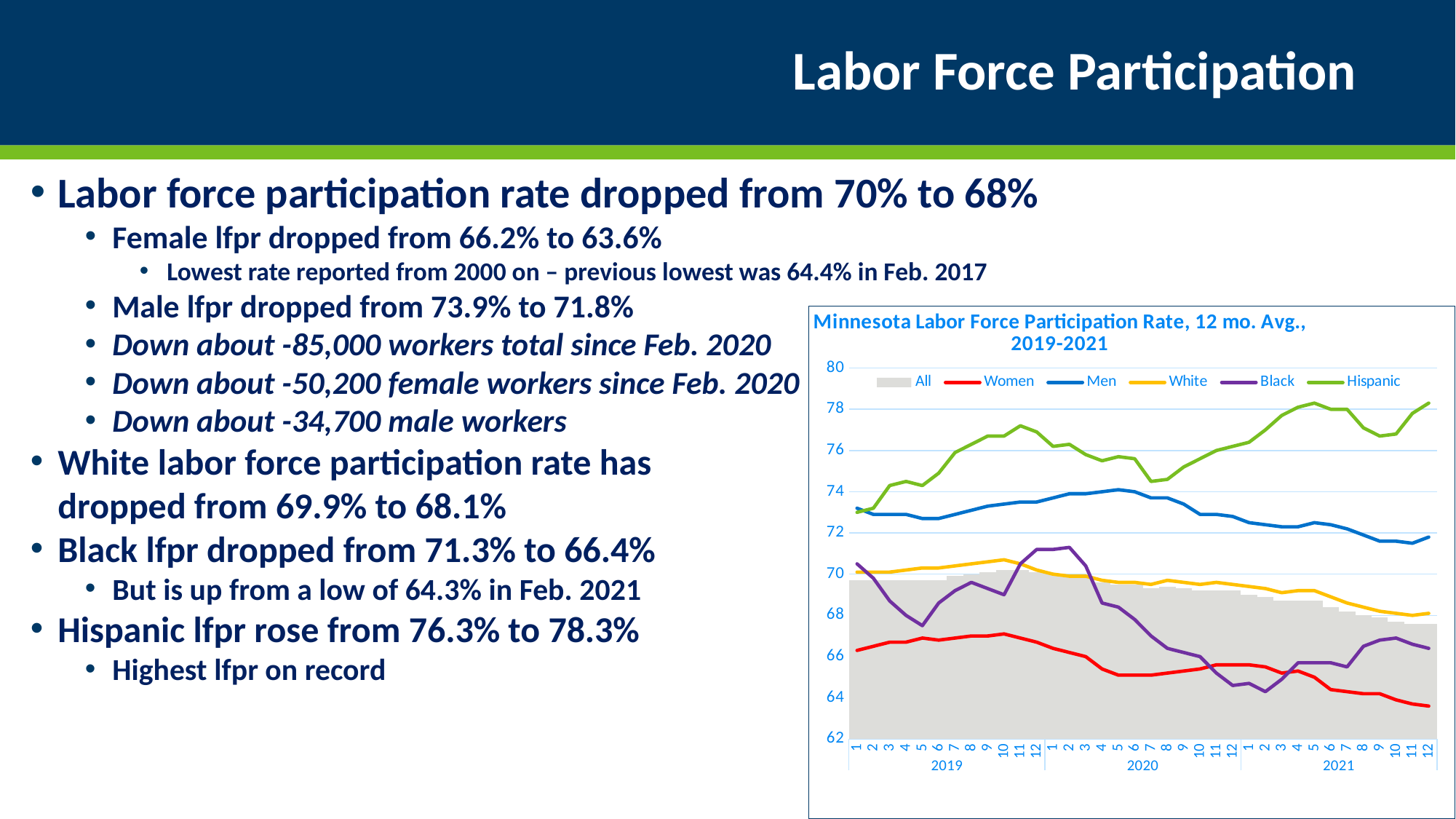
How many series does the chart legend list? 6 What kind of chart is shown on the slide? Combination bar and line chart What is the title of the chart? Minnesota Labor Force Participation Rate, 12 mo. Avg., 2019-2021 Is the value for Black at month 1 of 2020 greater or less than 70? greater Is the value for Men at month 1 of 2019 greater or less than 72? greater Does the Women series rise or fall from the start of 2020 to the end of 2021? Fall Is the value for Hispanic at month 1 of 2019 greater or less than 74? less Which series is plotted as a shaded grey area rather than a line? All Which series has the lowest value at month 12 of 2021? Women At month 12 of 2021, which is larger, the value for Men or the value for White? Men